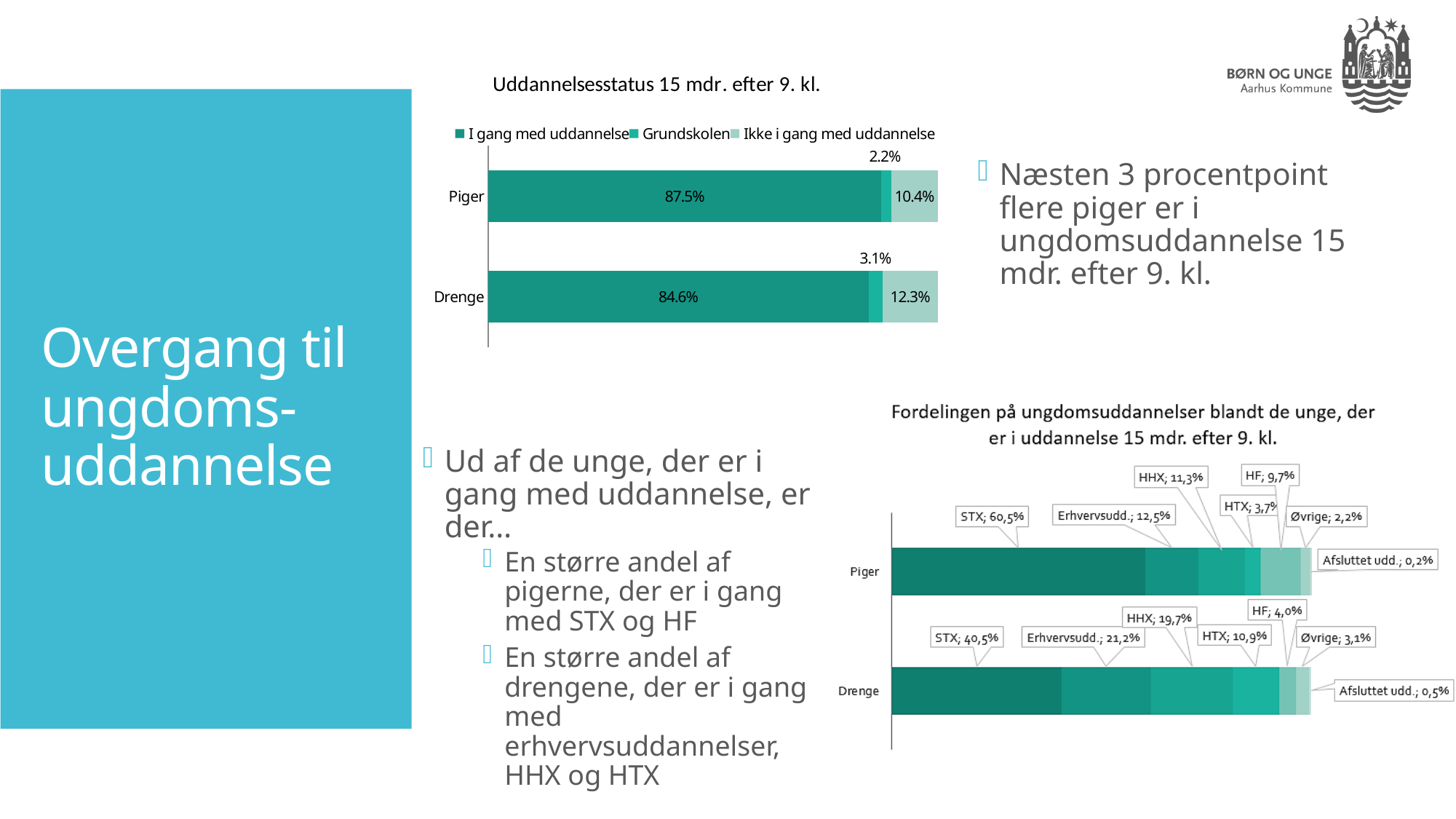
In the chart 'Uddannelsesstatus 15 mdr. efter 9. kl.', how many series does the legend list? 3 In the chart 'Fordelingen på ungdomsuddannelser blandt de unge, der er i uddannelse 15 mdr. efter 9. kl.', what is the STX share for Piger? 60,5% In the chart 'Uddannelsesstatus 15 mdr. efter 9. kl.', which group has the larger 'Ikke i gang med uddannelse' value, Piger or Drenge? Drenge In the chart 'Fordelingen på ungdomsuddannelser blandt de unge, der er i uddannelse 15 mdr. efter 9. kl.', what is the HTX share for Piger? 3,7% In the chart 'Uddannelsesstatus 15 mdr. efter 9. kl.', what is the value for 'Grundskolen' for Drenge? 3.1% In the chart 'Uddannelsesstatus 15 mdr. efter 9. kl.', what is the value for 'I gang med uddannelse' for Piger? 87.5% What kind of chart is 'Uddannelsesstatus 15 mdr. efter 9. kl.'? Stacked bar chart In the chart 'Uddannelsesstatus 15 mdr. efter 9. kl.', what is the difference between the 'I gang med uddannelse' values for Piger and Drenge? 2.9 percentage points In the chart 'Fordelingen på ungdomsuddannelser blandt de unge, der er i uddannelse 15 mdr. efter 9. kl.', which segment is the largest for Drenge? STX In the chart 'Fordelingen på ungdomsuddannelser blandt de unge, der er i uddannelse 15 mdr. efter 9. kl.', what is the Erhvervsudd. share for Drenge? 21,2% In the chart 'Fordelingen på ungdomsuddannelser blandt de unge, der er i uddannelse 15 mdr. efter 9. kl.', what is the difference between the HHX shares for Drenge and Piger? 8,4 percentage points In the chart 'Uddannelsesstatus 15 mdr. efter 9. kl.', what is the value for 'Ikke i gang med uddannelse' for Drenge? 12.3%